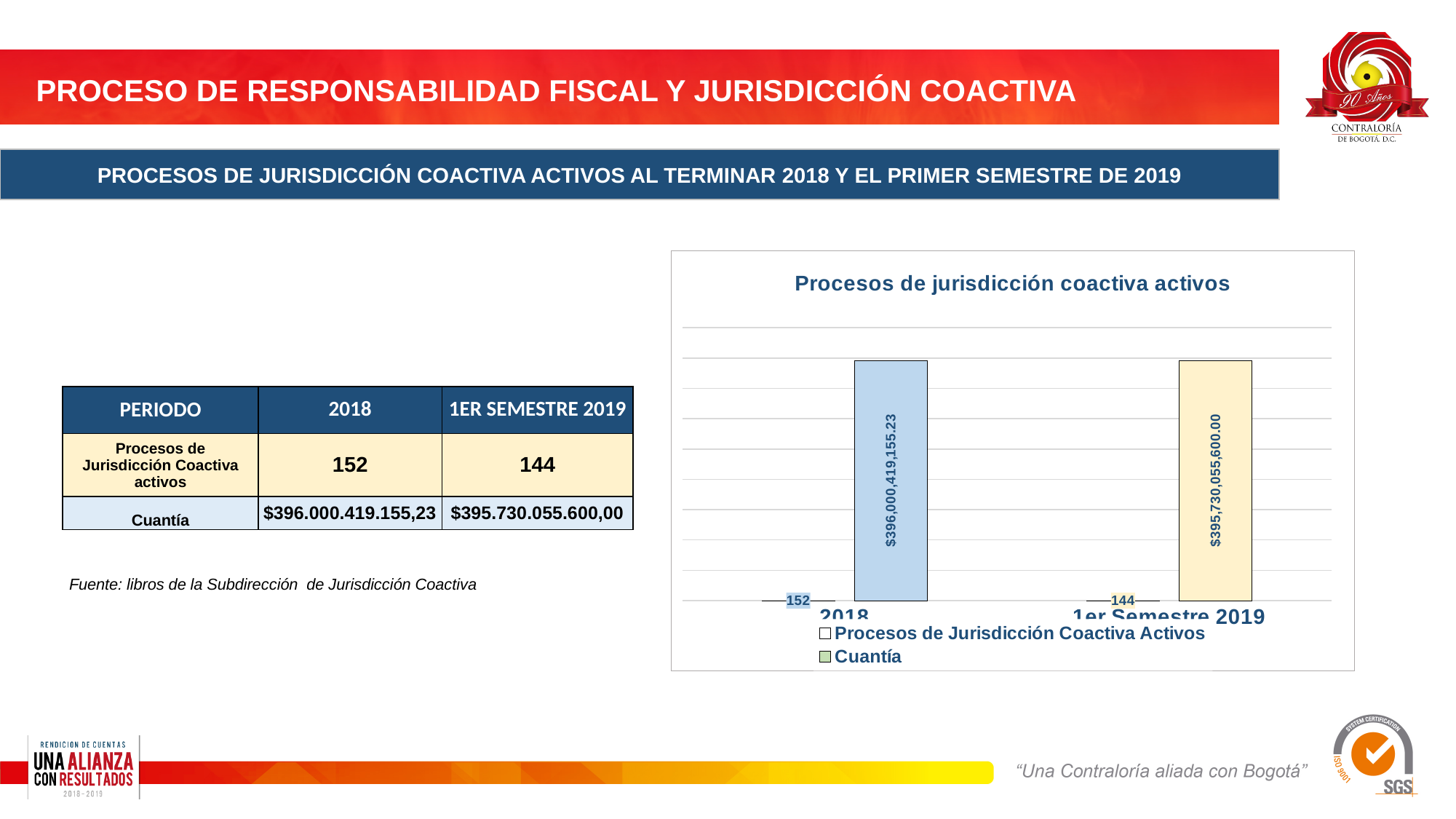
What is the Cuantía value labelled on the 2018 bar in the chart? $396,000,419,155.23 How many series does the chart legend list? 2 Which period has the higher number of Procesos de Jurisdicción Coactiva Activos, 2018 or 1er Semestre 2019? 2018 How many categories are shown on the x axis of the chart? 2 What is the value of Procesos de Jurisdicción Coactiva Activos for 1er Semestre 2019 in the chart? 144 Do the Procesos de Jurisdicción Coactiva Activos values rise or fall from 2018 to 1er Semestre 2019? fall What is the value of Procesos de Jurisdicción Coactiva Activos for 2018 in the chart? 152 What is the Cuantía value labelled on the 1er Semestre 2019 bar in the chart? $395,730,055,600.00 What type of chart is shown on the slide? bar chart What is the title of the chart? Procesos de jurisdicción coactiva activos What is the difference between the Procesos de Jurisdicción Coactiva Activos values for 2018 and 1er Semestre 2019? 8 Which series in the chart is shown with the light blue bar for 2018? Cuantía